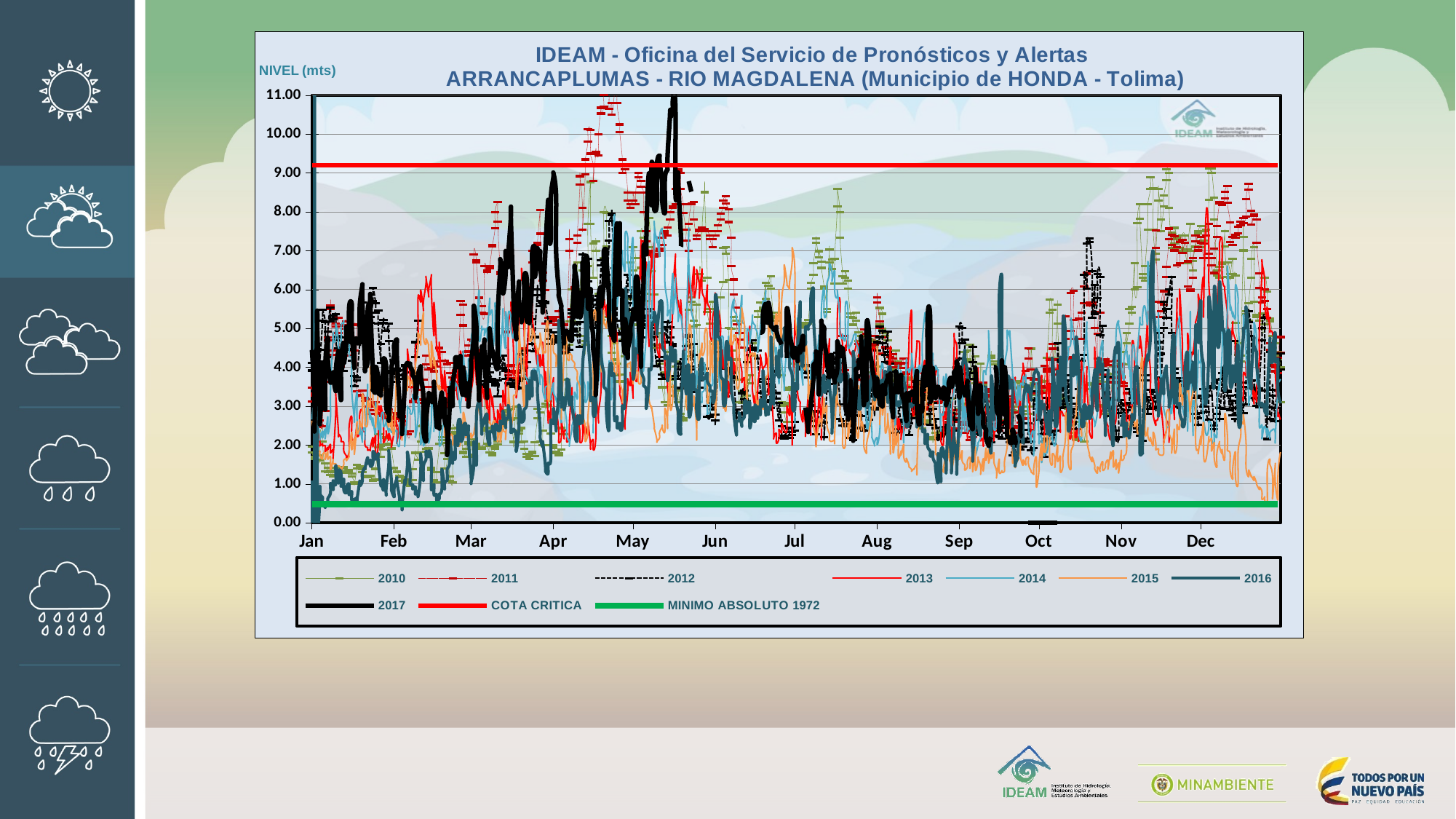
Is the peak value of the 2017 series in May greater or less than 10.00? greater What kind of chart is shown on the slide? line chart Is the value of the 2016 series in January greater or less than 2.00? less What is the label of the vertical axis? NIVEL (mts) Is the COTA CRITICA line greater or less than 9.00? greater How many entries does the chart legend list? 10 In which month does the 2017 series reach its highest level? May Which station and river does the chart title name? ARRANCAPLUMAS - RIO MAGDALENA Which is higher on the chart, the COTA CRITICA line or the MINIMO ABSOLUTO 1972 line? COTA CRITICA How many months are labelled along the x axis? 12